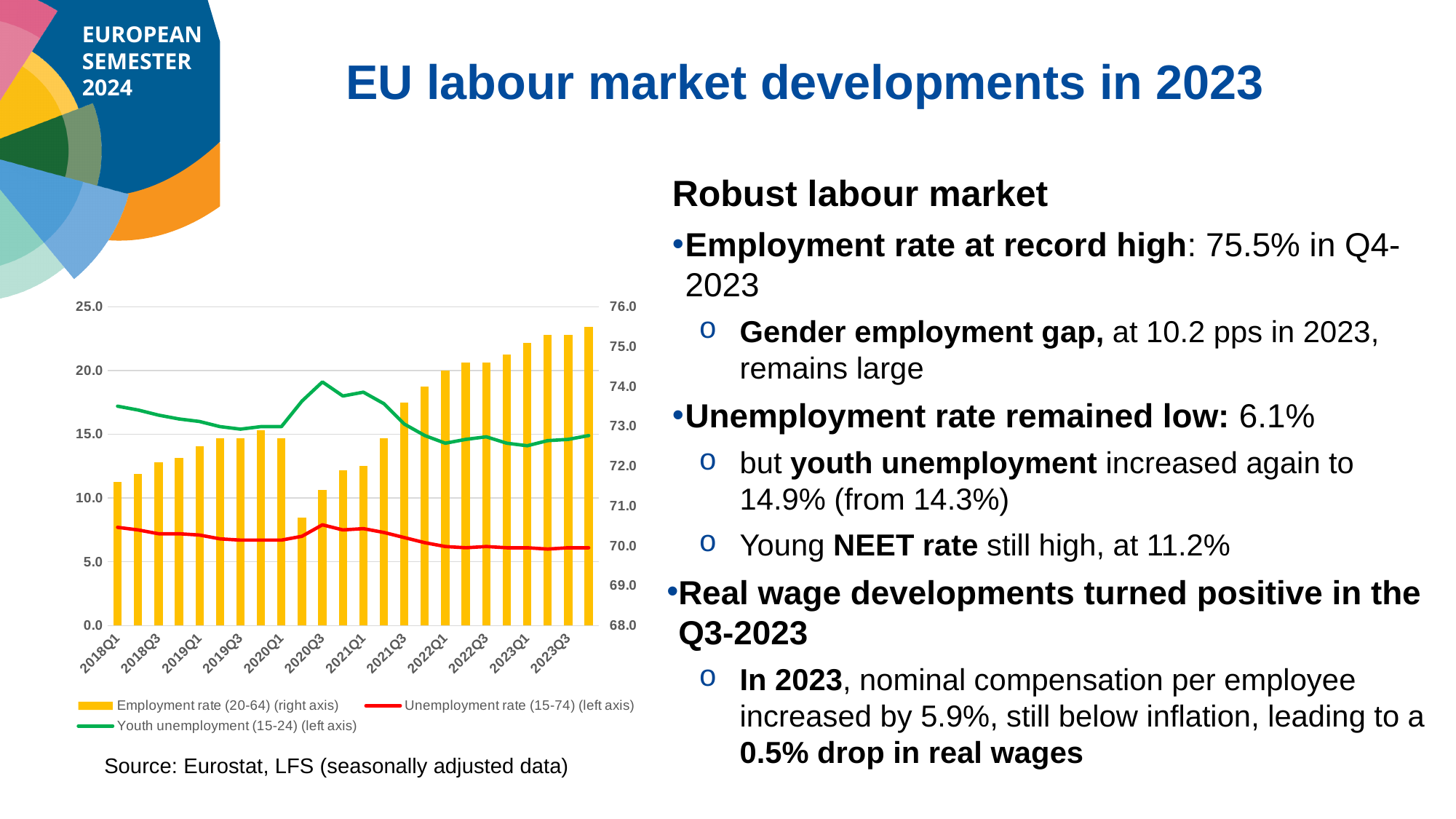
What kind of chart is shown on the slide? A combined bar and line chart Which is larger, the youth unemployment value in 2020Q3 or in 2023Q3? 2020Q3 Do the employment rate bars generally rise or fall from 2018Q1 to 2023Q3? Rise Is the unemployment rate (15-74) for 2023Q3 greater or less than 10.0? less Which line is higher throughout the chart, the youth unemployment line or the unemployment rate (15-74) line? Youth unemployment (15-24) How many bars are plotted in the chart? 24 Is the employment rate for 2023Q3 greater or less than 74.0? greater How many series does the chart legend list? 3 On which axis is the Youth unemployment (15-24) series plotted? Left axis Is the youth unemployment value for 2020Q3 greater or less than 15.0? greater Which series is plotted as bars in the chart? Employment rate (20-64) (right axis)